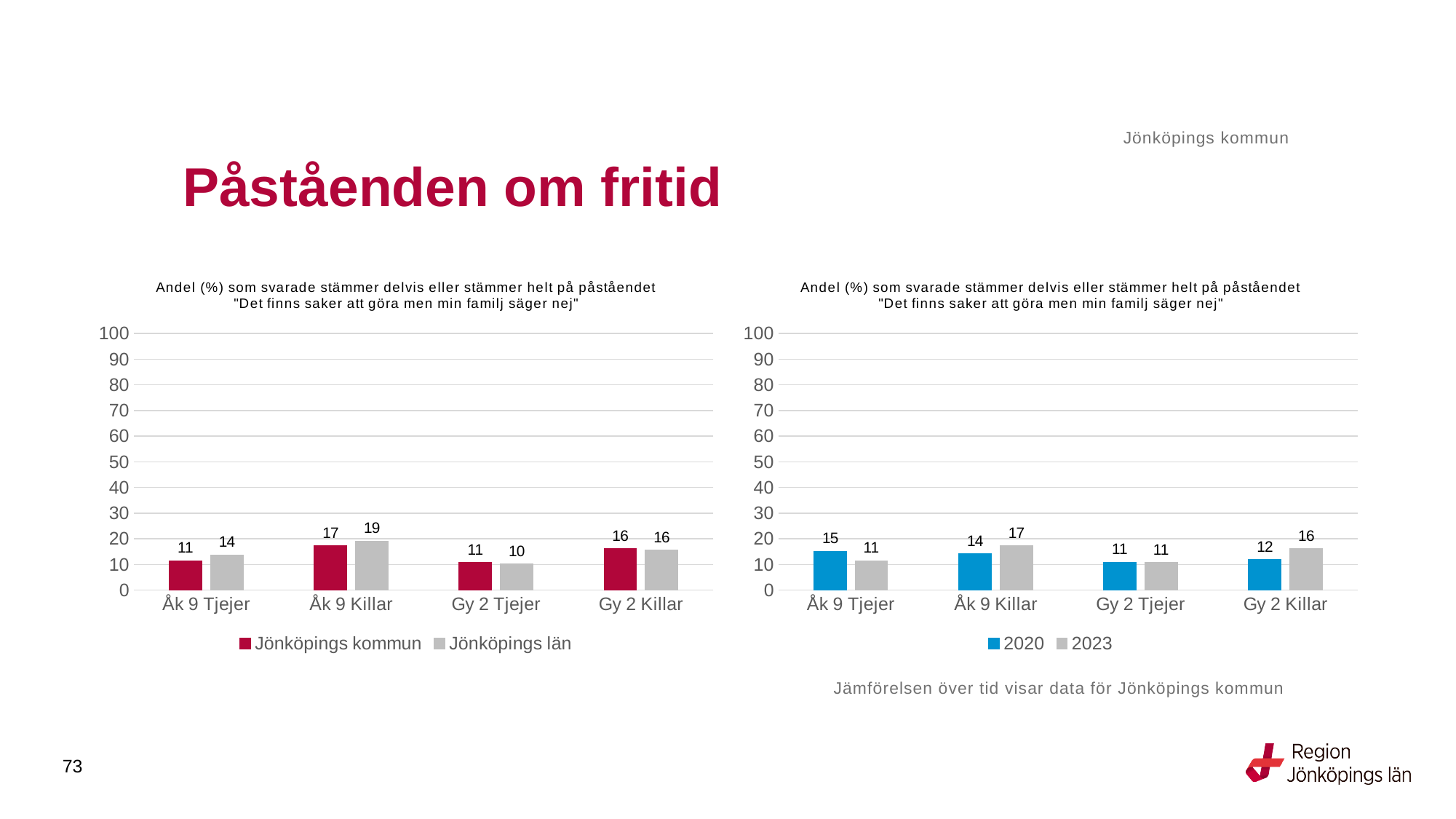
In the left chart, what is the value for Jönköpings län for Gy 2 Tjejer? 10 In the right chart, what is the difference between 2023 and 2020 for Gy 2 Killar? 4 In the right chart, what is the value for 2020 for Åk 9 Tjejer? 15 In the left chart, which category has the highest value for Jönköpings län? Åk 9 Killar In the left chart, what is the value for Jönköpings kommun for Åk 9 Killar? 17 How many categories are shown on the x axis of the right chart? 4 In the left chart, how many series does the legend list? 2 In the right chart, is the 2023 value for Åk 9 Killar larger or smaller than the 2020 value? larger In the left chart, what is the difference between Jönköpings län and Jönköpings kommun for Åk 9 Tjejer? 3 In the right chart, what is the value for 2023 for Gy 2 Killar? 16 In the right chart, which category has the lowest value for 2023? Åk 9 Tjejer and Gy 2 Tjejer (both 11) What type of chart is the left chart? Bar chart